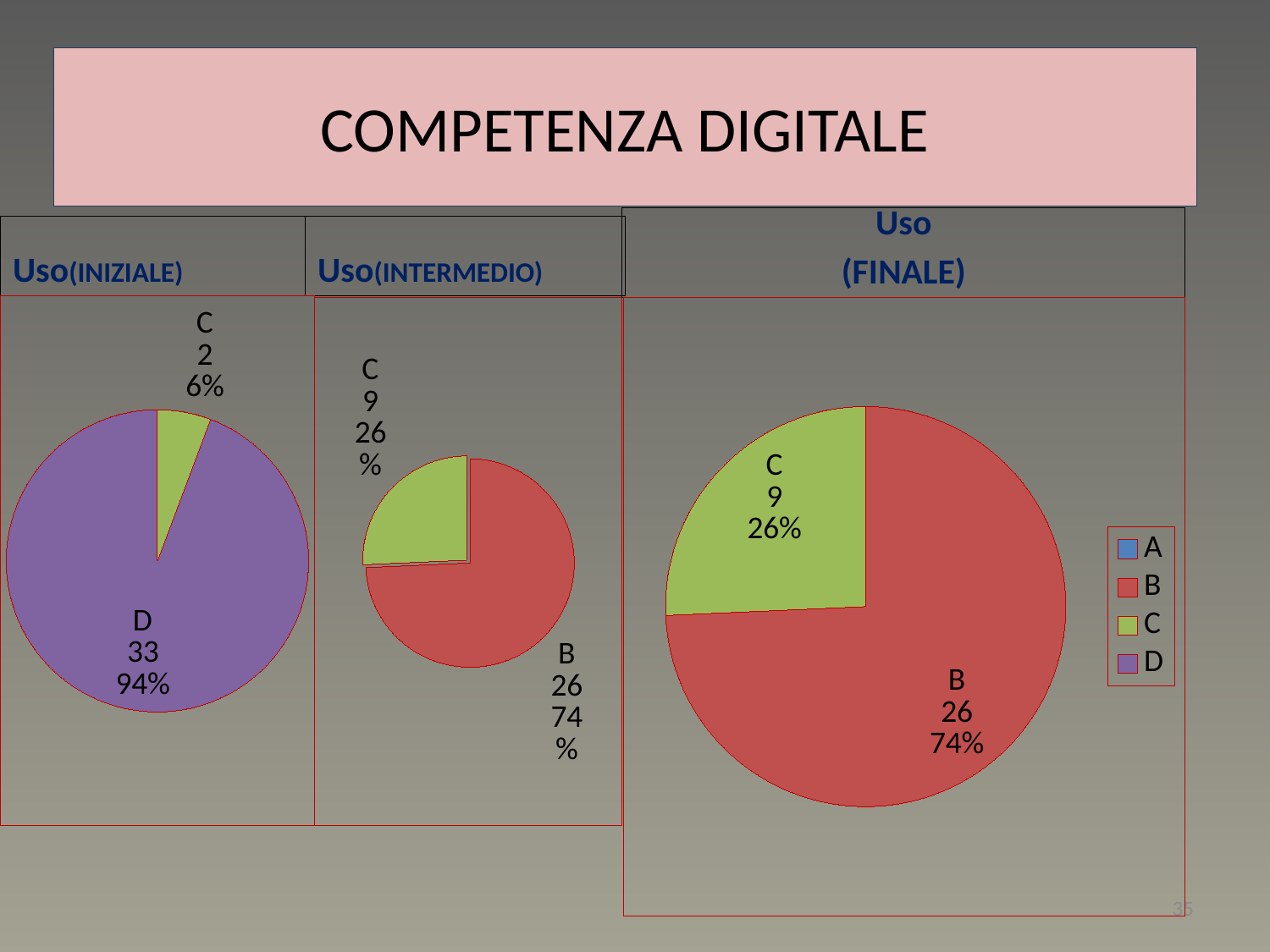
In the Uso (FINALE) pie chart, what is the difference between the values for B and C? 17 In the Uso (INTERMEDIO) pie chart, what value is shown for category C? 9 In the Uso (FINALE) pie chart, what percentage share does category B have? 74% In the Uso (INIZIALE) pie chart, what percentage share does category C have? 6% In the Uso (FINALE) pie chart, what percentage share does category C have? 26% How many entries does the legend on the right of the slide list? 4 In the Uso (INIZIALE) pie chart, which category has the smallest slice? C What kind of chart is used for Uso (INTERMEDIO)? Pie chart In the Uso (FINALE) pie chart, which category has the largest slice? B In the Uso (INTERMEDIO) pie chart, what value is shown for category B? 26 In the Uso (INIZIALE) pie chart, what value is shown for category D? 33